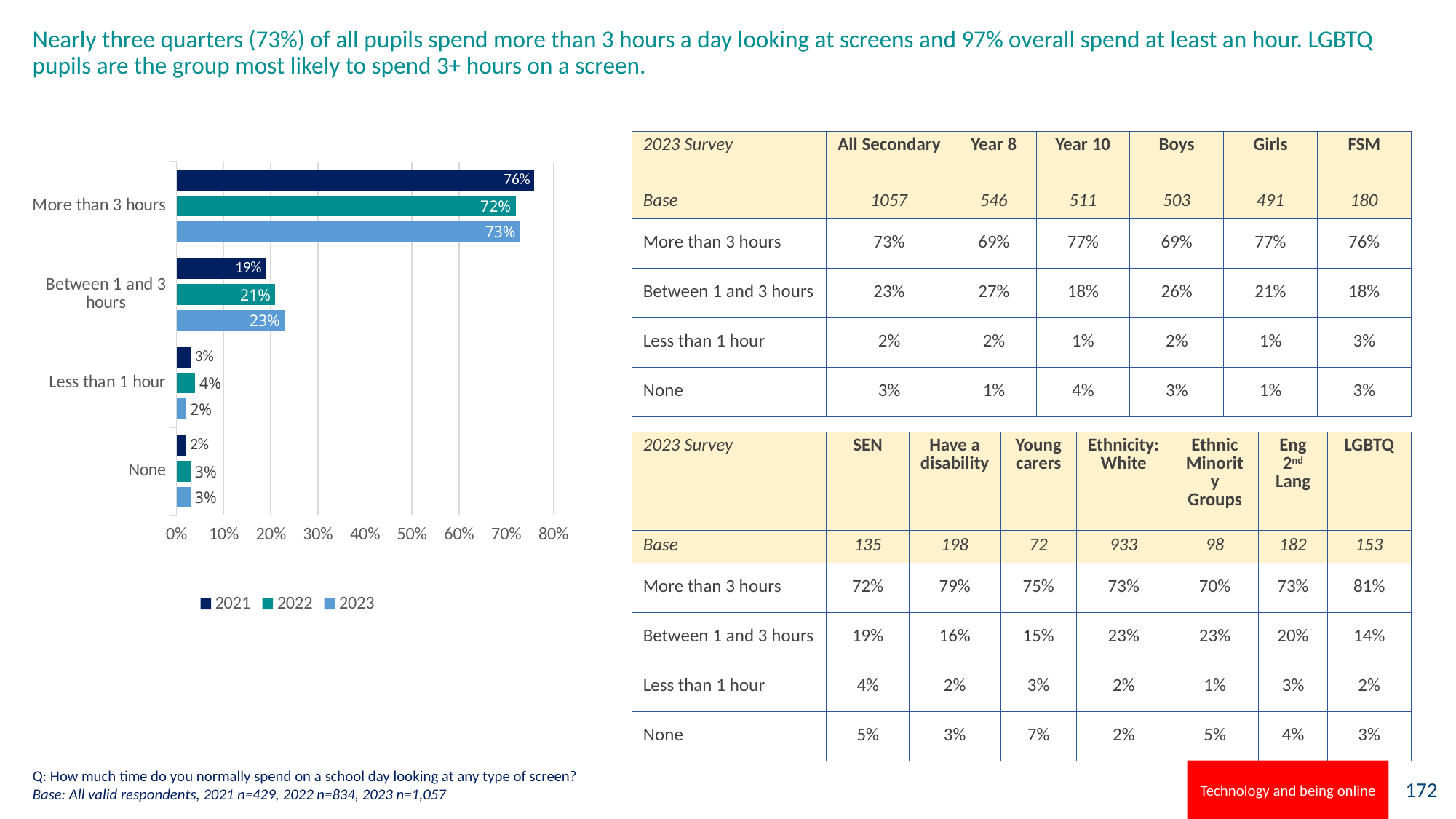
What percentage of pupils spent more than 3 hours looking at screens in 2021? 76% What percentage of pupils answered 'None' in 2021? 2% How many series does the legend list? 3 What is the difference between the 2021 and 2023 values for 'Between 1 and 3 hours'? 4% Which series is shown in the darkest blue colour? 2021 Which category has the highest value for the 2023 series? More than 3 hours What percentage of pupils spent between 1 and 3 hours looking at screens in 2023? 23% How many categories are shown on the chart? 4 What percentage of pupils spent less than 1 hour looking at screens in 2022? 4% What kind of chart is shown on the slide? Bar chart Which is larger for 'More than 3 hours': the 2021 value or the 2023 value? 2021 Which year has the lowest value for 'More than 3 hours'? 2022